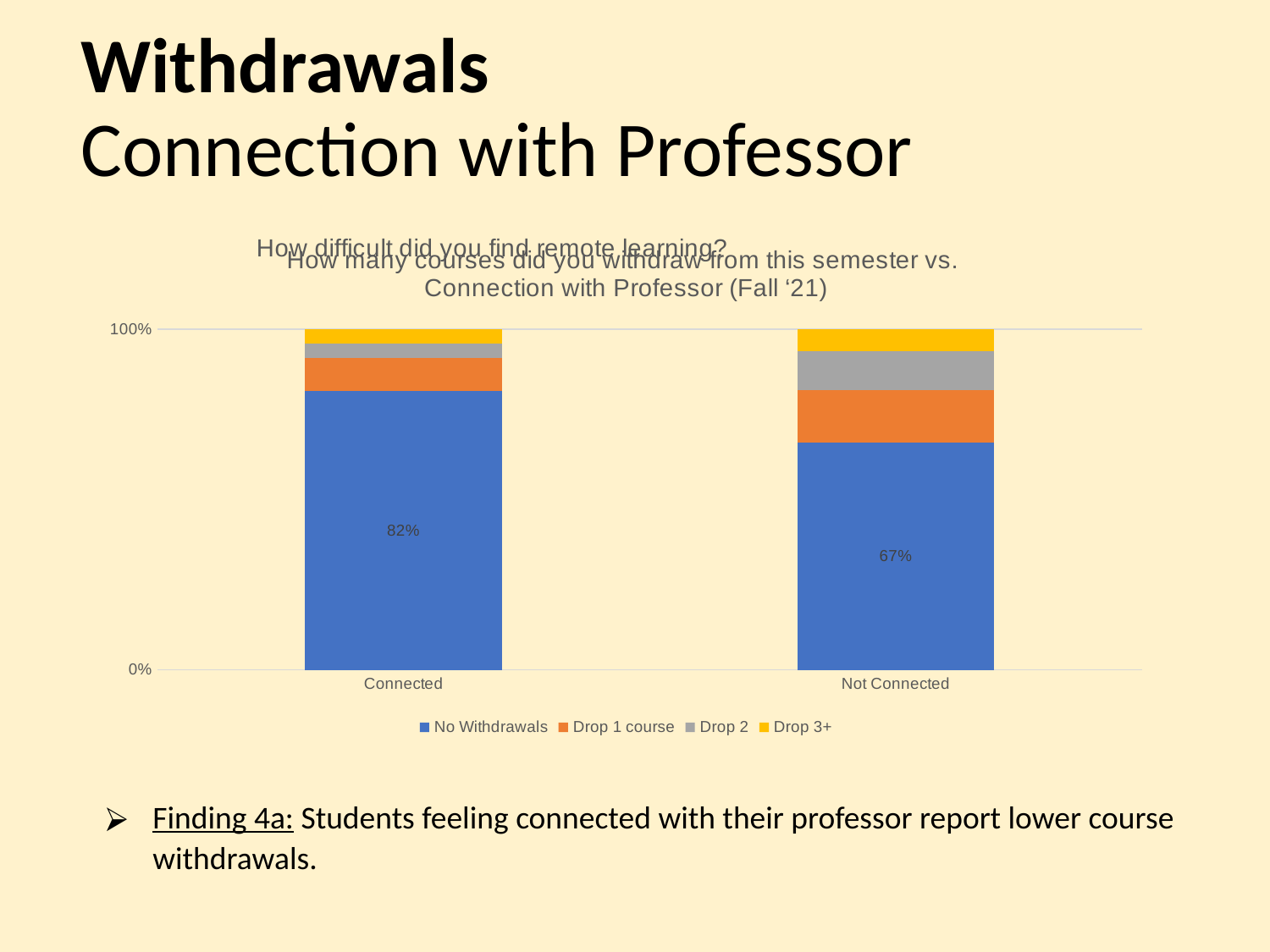
What are the four series listed in the chart's legend? No Withdrawals, Drop 1 course, Drop 2, Drop 3+ What percentage of Not Connected students reported No Withdrawals? 67% What percentage of Connected students reported No Withdrawals? 82% How many series does the chart's legend list? 4 Which group has the larger Drop 2 segment, Connected or Not Connected? Not Connected What is the difference between the No Withdrawals share for Connected students and for Not Connected students? 15 percentage points Which group has the larger Drop 1 course segment, Connected or Not Connected? Not Connected Which group has the larger No Withdrawals share, Connected or Not Connected? Connected What kind of chart is shown on the slide? Stacked bar chart Which category has the highest No Withdrawals percentage? Connected What colour represents the No Withdrawals series in the chart? Blue How many categories are shown on the x axis of the chart? 2